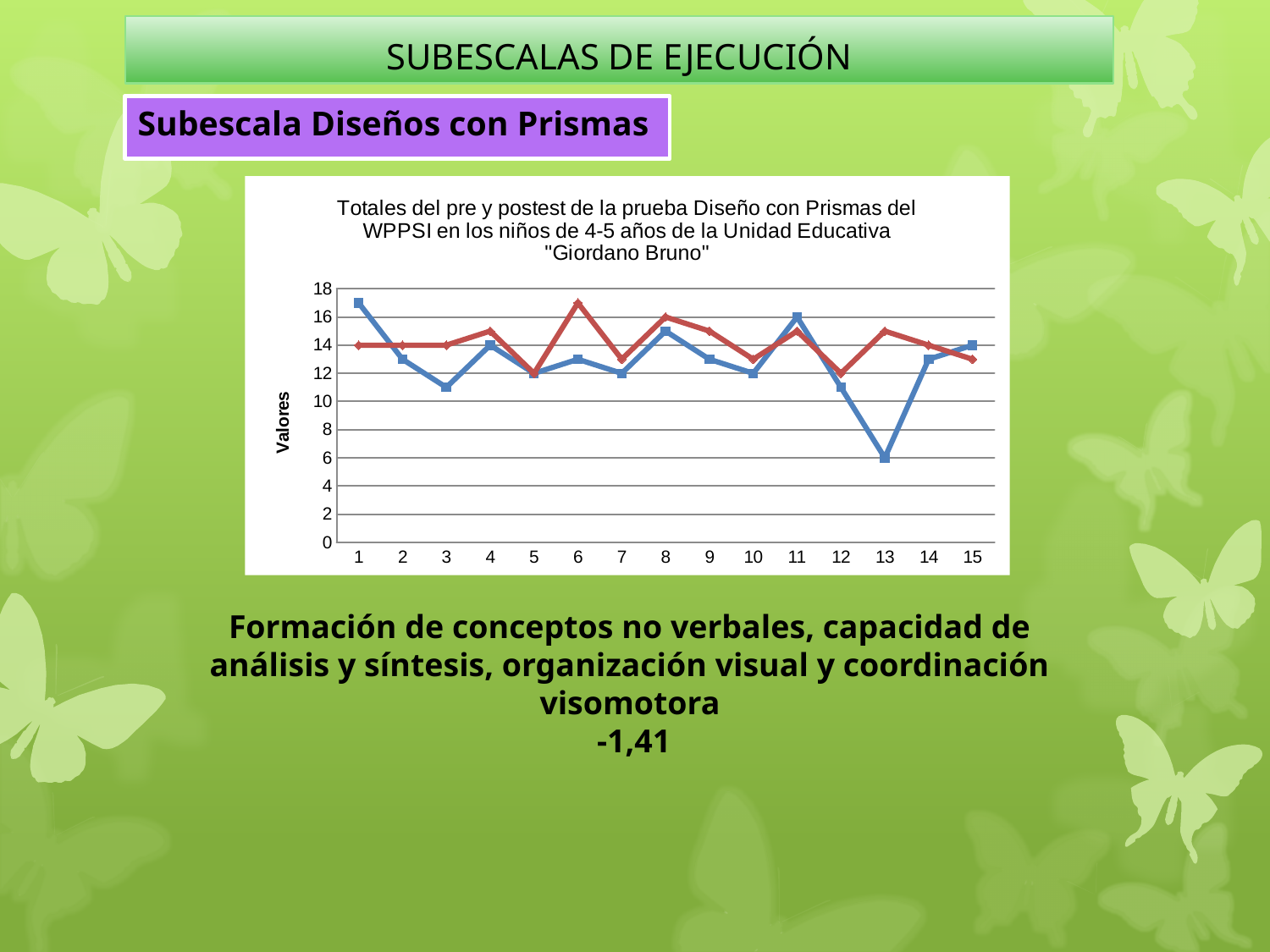
What kind of chart is shown on the slide? line chart What is the value of the red line at x = 1? 14 Is the value of the blue line at x = 3 greater or less than 12? less How many points are plotted along the x axis of the chart? 15 At x = 1, which line has the higher value, the blue line or the red line? blue line At which x value does the blue line reach its lowest point? 13 What is the value of the blue line at x = 13? 6 At which x value does the red line reach its highest point? 6 What is the value of the red line at x = 8? 16 What is the label of the vertical axis of the chart? Valores What is the value of the blue line at x = 11? 16 How many lines (series) are plotted in the chart? 2